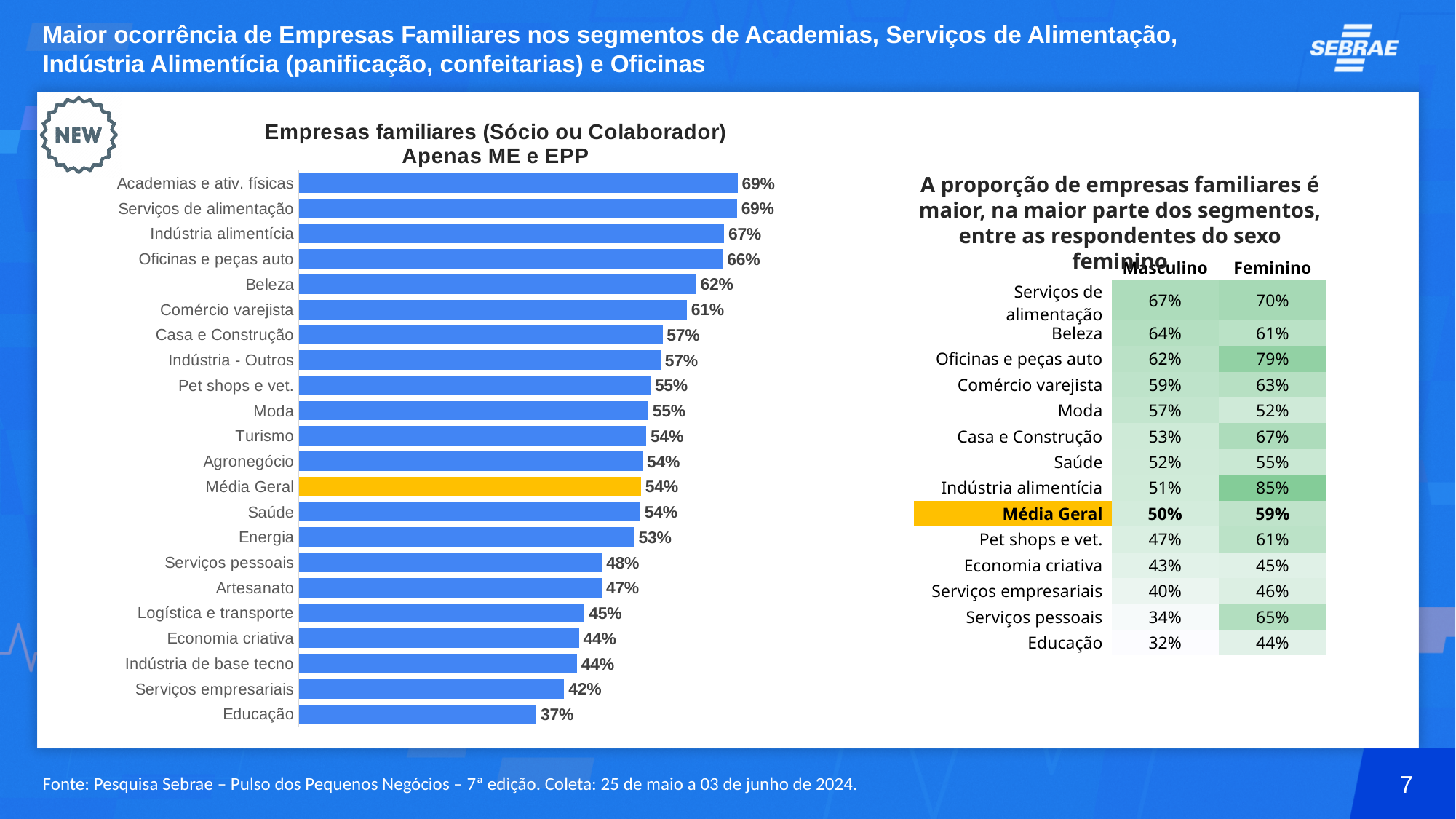
How many categories are shown in the bar chart? 22 What is the difference between the values for Oficinas e peças auto and Média Geral in the bar chart? 12% Which category has the lowest value in the bar chart? Educação What is the value for Beleza in the bar chart? 62% What type of chart is shown on the slide? bar chart Which has a larger value in the bar chart, Comércio varejista or Artesanato? Comércio varejista What is the value for Indústria alimentícia in the bar chart? 67% What is the title of the bar chart? Empresas familiares (Sócio ou Colaborador) Apenas ME e EPP What is the difference between the values for Academias e ativ. físicas and Educação in the bar chart? 32% Which bar in the chart is highlighted in a different colour (yellow) from the others? Média Geral What is the value for Educação in the bar chart? 37% What is the value for Média Geral in the bar chart? 54%